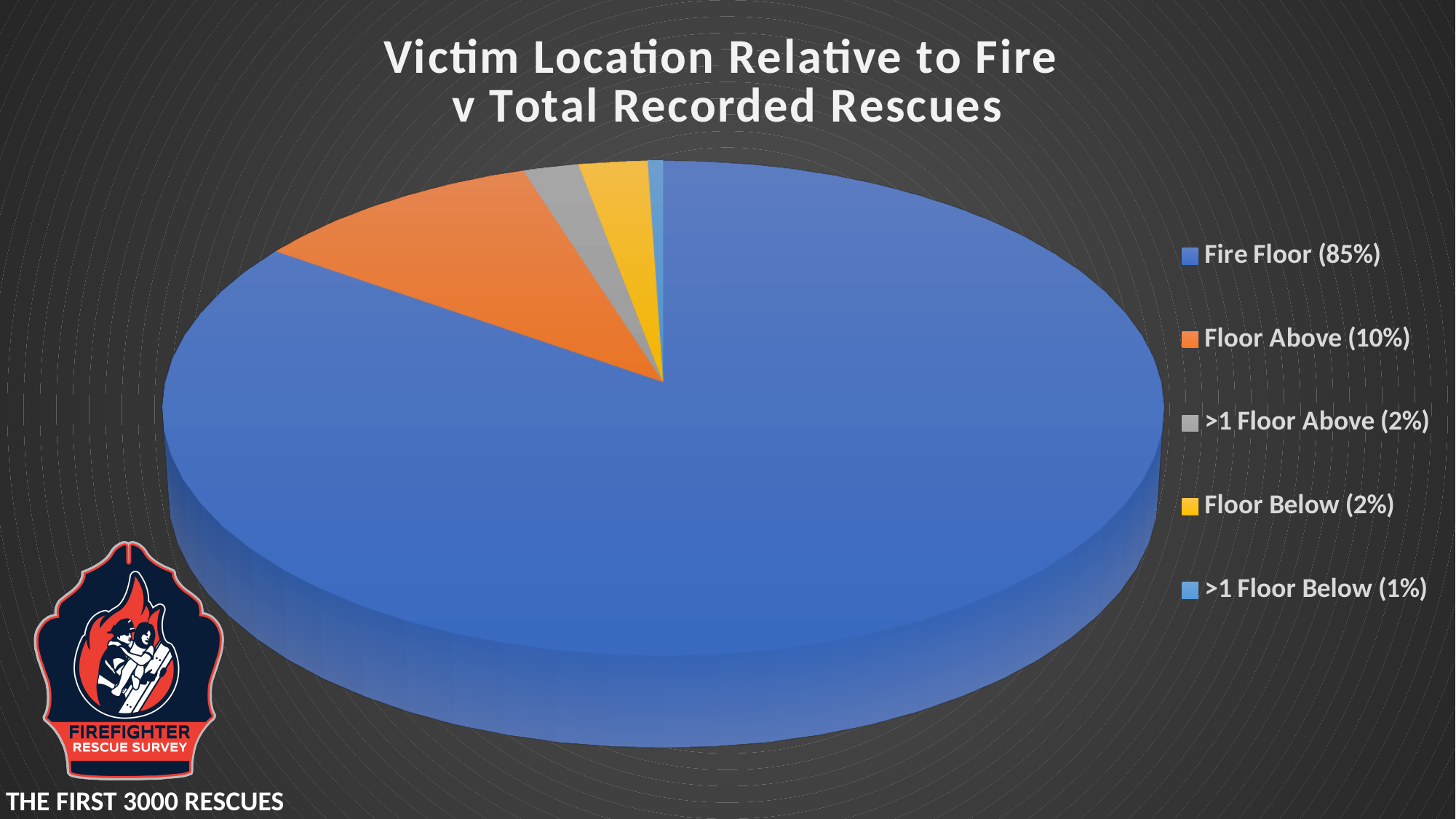
Which category has the largest slice of the pie? Fire Floor What share of rescues is shown for >1 Floor Below? 1% What is the title of the chart? Victim Location Relative to Fire v Total Recorded Rescues What share of rescues is shown for Fire Floor? 85% What is the difference in percentage points between Fire Floor and Floor Above? 75 What share of rescues is shown for Floor Above? 10% Which is larger, the share for Floor Above or the share for Floor Below? Floor Above What kind of chart is shown on the slide? Pie chart What colour is the Fire Floor slice? Blue How many categories does the legend list? 5 Which category has the smallest slice of the pie? >1 Floor Below